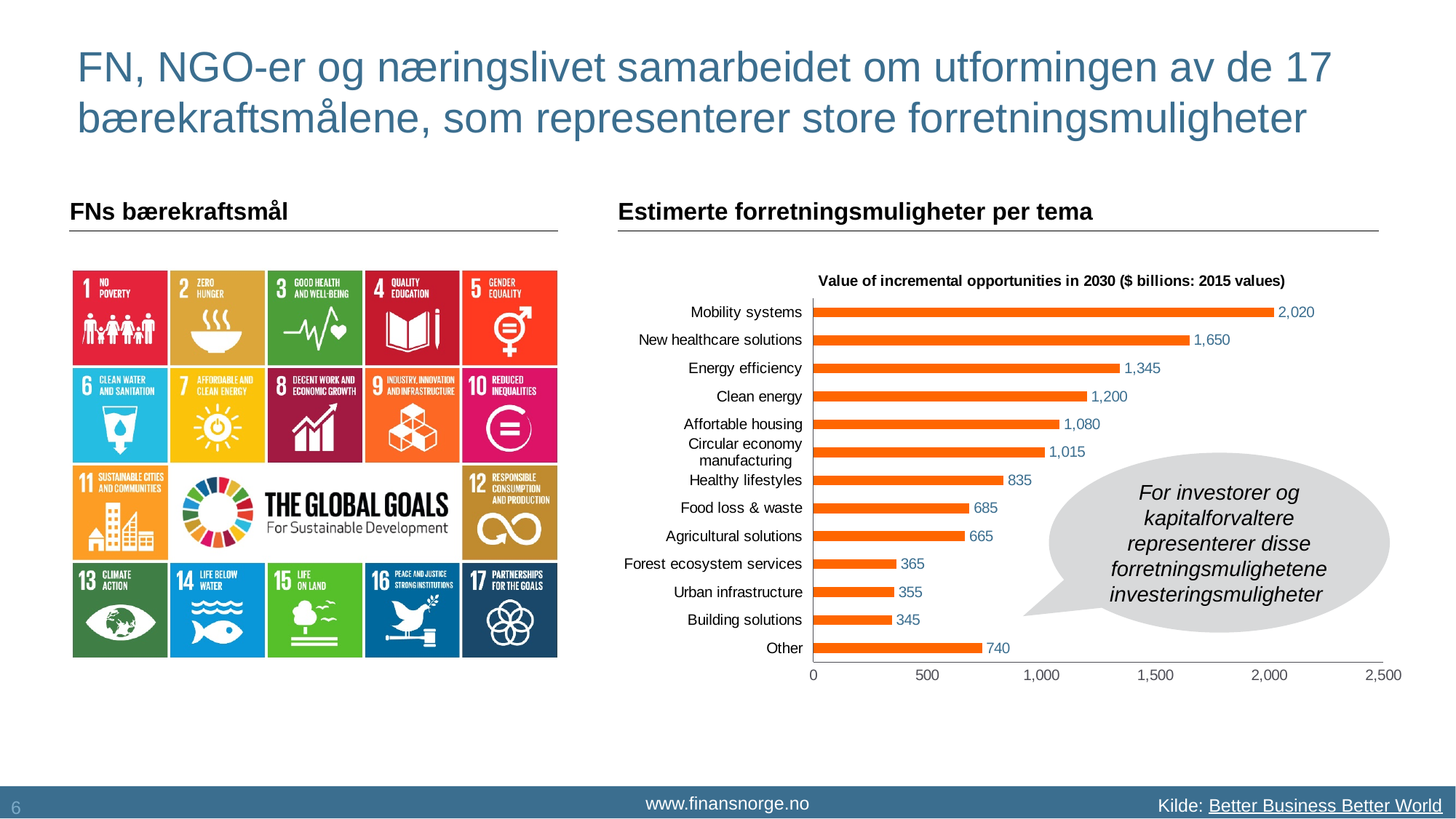
How many categories are shown in the chart? 13 Which is larger, the value for Healthy lifestyles or the value for Other? Healthy lifestyles Which category has the highest value? Mobility systems What is the value for Other? 740 What is the value for Clean energy? 1,200 What kind of chart is shown on the slide? Bar chart Which category has the lowest value? Building solutions What is the title of the chart? Value of incremental opportunities in 2030 ($ billions: 2015 values) What is the difference between the values for Energy efficiency and Clean energy? 145 What is the value for Mobility systems? 2,020 What is the value for Food loss & waste? 685 What is the difference between the values for Mobility systems and New healthcare solutions? 370